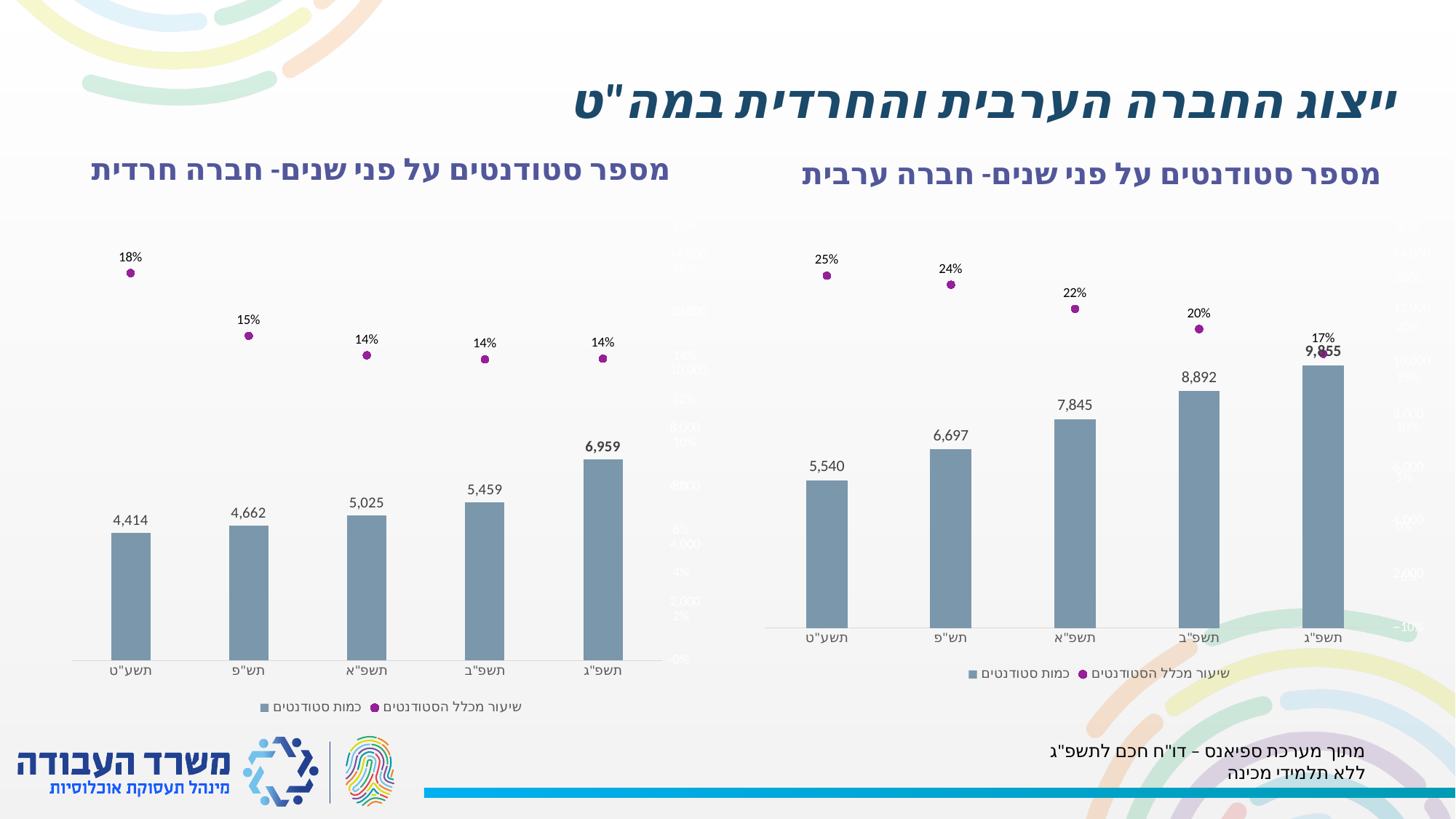
In the chart titled "מספר סטודנטים על פני שנים- חברה ערבית" (right), what is the number of students (כמות סטודנטים) for תשפ"ג? 9,855 In the right chart (חברה ערבית), what is the difference in the number of students between תשפ"ג and תשע"ט? 4,315 How many years (categories) are shown on the x axis of the left chart (חברה חרדית)? 5 In the right chart (חברה ערבית), which is larger: the share of all students in תש"פ or in תשפ"ב? תש"פ In the chart titled "מספר סטודנטים על פני שנים- חברה חרדית" (left), what is the share of all students for תש"פ? 15% In the chart titled "מספר סטודנטים על פני שנים- חברה חרדית" (left), what is the number of students for תשפ"ב? 5,459 In the right chart (חברה ערבית), which year has the highest number of students? תשפ"ג In the chart titled "מספר סטודנטים על פני שנים- חברה ערבית" (right), what is the share of all students (שיעור מכלל הסטודנטים) for תשע"ט? 25% In the left chart (חברה חרדית), which year has the lowest number of students? תשע"ט In the right chart (חברה ערבית), does the share of all students rise or fall from תשע"ט to תשפ"ג? fall How many series does the legend of the right chart (חברה ערבית) list? 2 In the left chart (חברה חרדית), what is the difference in the number of students between תשפ"ג and תשפ"ב? 1,500